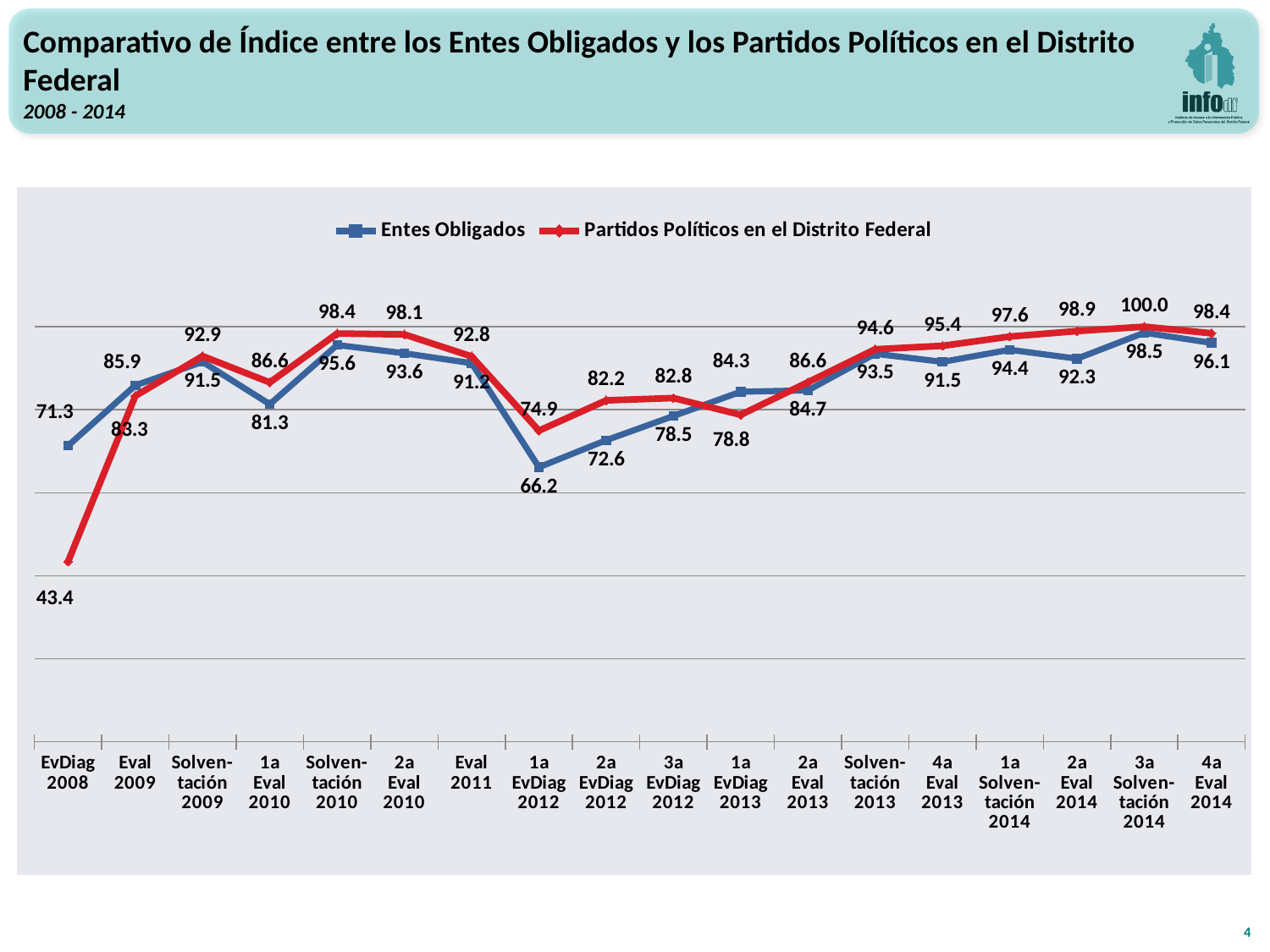
What kind of chart is shown on the slide? Line chart How many evaluation periods are plotted along the x axis? 18 What colour is the line for Partidos Políticos en el Distrito Federal? Red What is the difference between Partidos Políticos en el Distrito Federal and Entes Obligados at Solventación 2010? 2.8 What is the value for Entes Obligados at 1a EvDiag 2012? 66.2 What is the difference between Entes Obligados and Partidos Políticos en el Distrito Federal at EvDiag 2008? 27.9 At 1a EvDiag 2013, which series has the higher value? Entes Obligados How many series does the legend list? 2 At which period does Partidos Políticos en el Distrito Federal reach its highest value? 3a Solventación 2014 What is the value for Entes Obligados at 3a Solventación 2014? 98.5 At which period does Entes Obligados have its lowest value? 1a EvDiag 2012 What is the value for Partidos Políticos en el Distrito Federal at EvDiag 2008? 43.4